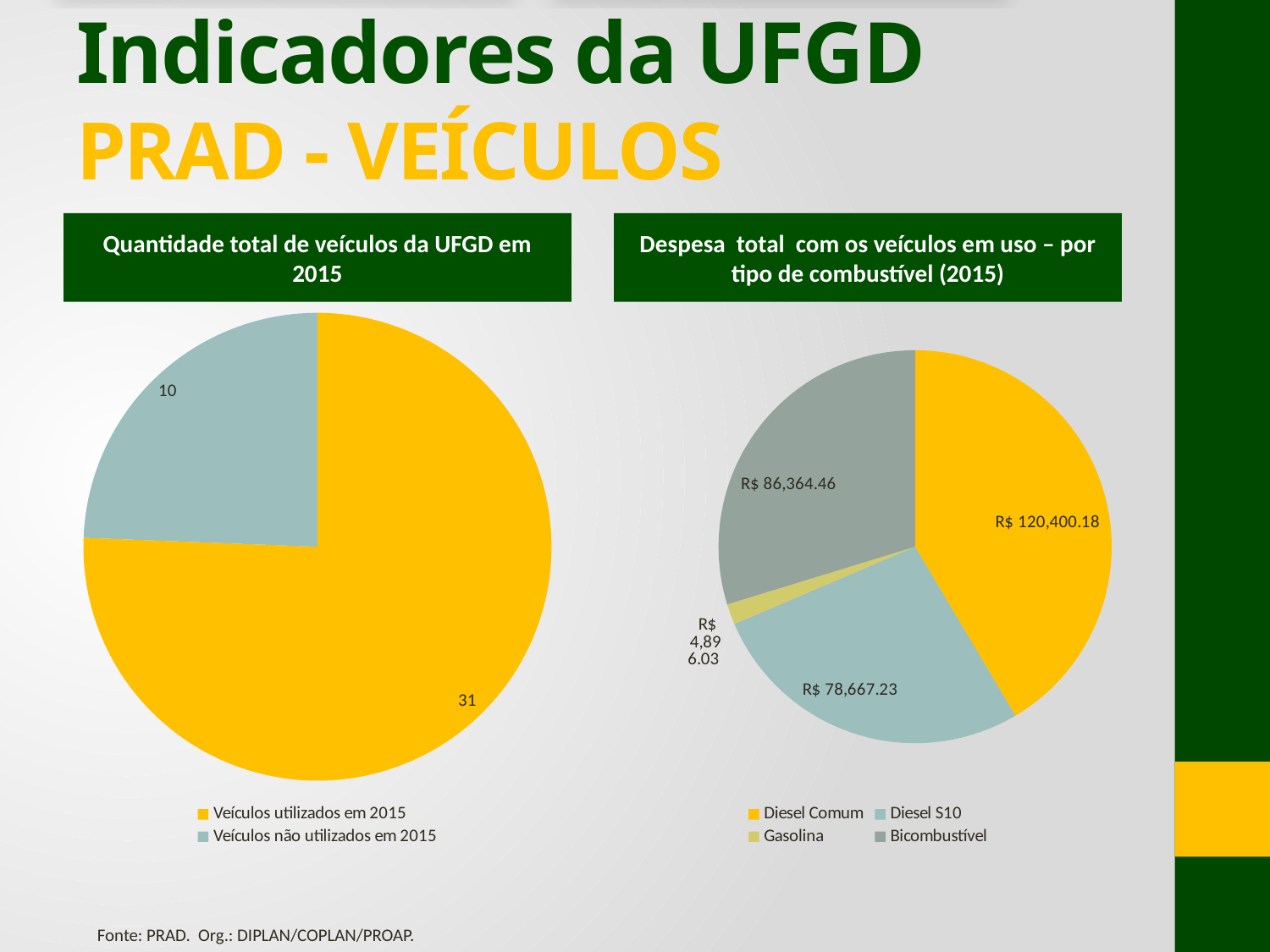
In the chart 'Despesa total com os veículos em uso – por tipo de combustível (2015)', what is the difference between the Diesel Comum and Diesel S10 expenses? R$ 41,732.95 In the chart 'Despesa total com os veículos em uso – por tipo de combustível (2015)', what is the value for Diesel S10? R$ 78,667.23 How many fuel types does the legend of the chart 'Despesa total com os veículos em uso – por tipo de combustível (2015)' list? 4 In the chart 'Quantidade total de veículos da UFGD em 2015', what is the total number of vehicles across both slices? 41 What kind of chart is 'Quantidade total de veículos da UFGD em 2015'? Pie chart In the chart 'Despesa total com os veículos em uso – por tipo de combustível (2015)', which fuel type has the lowest expense? Gasolina In the chart 'Quantidade total de veículos da UFGD em 2015', what is the value for 'Veículos não utilizados em 2015'? 10 In the chart 'Despesa total com os veículos em uso – por tipo de combustível (2015)', which fuel type has the highest expense? Diesel Comum In the chart 'Despesa total com os veículos em uso – por tipo de combustível (2015)', what is the value for Diesel Comum? R$ 120,400.18 In the chart 'Quantidade total de veículos da UFGD em 2015', what is the difference between the vehicles used and not used in 2015? 21 In the chart 'Despesa total com os veículos em uso – por tipo de combustível (2015)', what is the value for Bicombustível? R$ 86,364.46 In the chart 'Quantidade total de veículos da UFGD em 2015', what is the value for 'Veículos utilizados em 2015'? 31